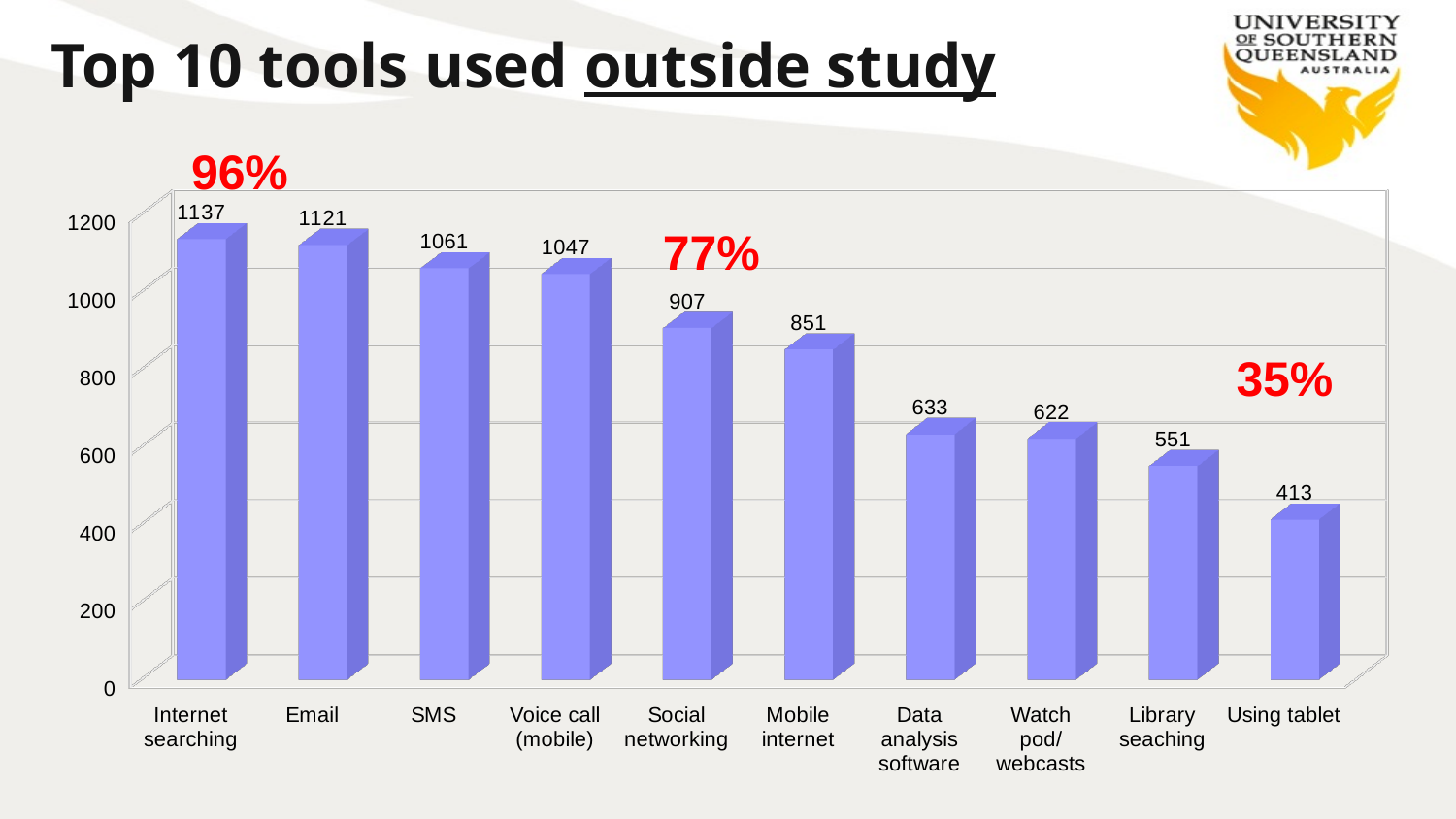
What is the value for Email? 1121 Which category has the lowest value? Using tablet What is the difference between the values for Internet searching and Using tablet? 724 Which is larger, the value for Mobile internet or the value for Data analysis software? Mobile internet How many categories are shown on the x axis? 10 What is the value for Using tablet? 413 What is the value for Social networking? 907 What kind of chart is shown on the slide? bar chart Is the value for Library seaching greater or less than 600? less Do the values rise or fall from left to right along the x axis? fall Which category has the highest value? Internet searching What is the difference between the values for SMS and Voice call (mobile)? 14